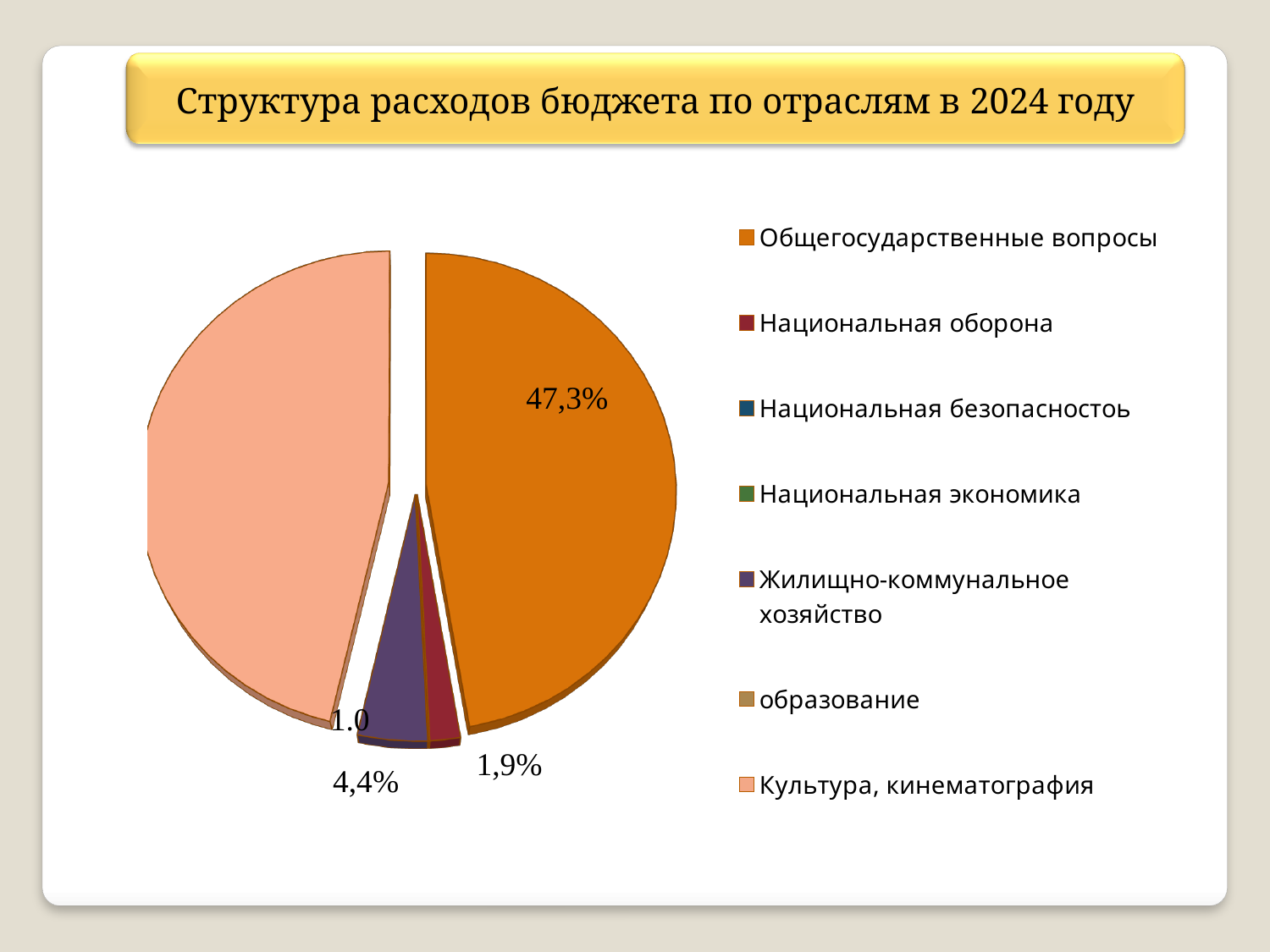
What kind of chart is shown on the slide? pie chart Which is larger, the share for Жилищно-коммунальное хозяйство or the share for Национальная оборона? Жилищно-коммунальное хозяйство Which is larger, the share for Общегосударственные вопросы or the share for Жилищно-коммунальное хозяйство? Общегосударственные вопросы What is the title of the chart? Структура расходов бюджета по отраслям в 2024 году What is the difference in percentage points between the share for Общегосударственные вопросы and the share for Жилищно-коммунальное хозяйство? 42,9 What colour is the slice for Культура, кинематография? light peach What share of the pie is labelled for Общегосударственные вопросы? 47,3% Is the share for Культура, кинематография greater or less than 25%? greater What share of the pie is labelled for Национальная оборона? 1,9% How many categories does the legend list? 7 What share of the pie is labelled for Жилищно-коммунальное хозяйство? 4,4% What is the difference in percentage points between the share for Жилищно-коммунальное хозяйство and the share for Национальная оборона? 2,5